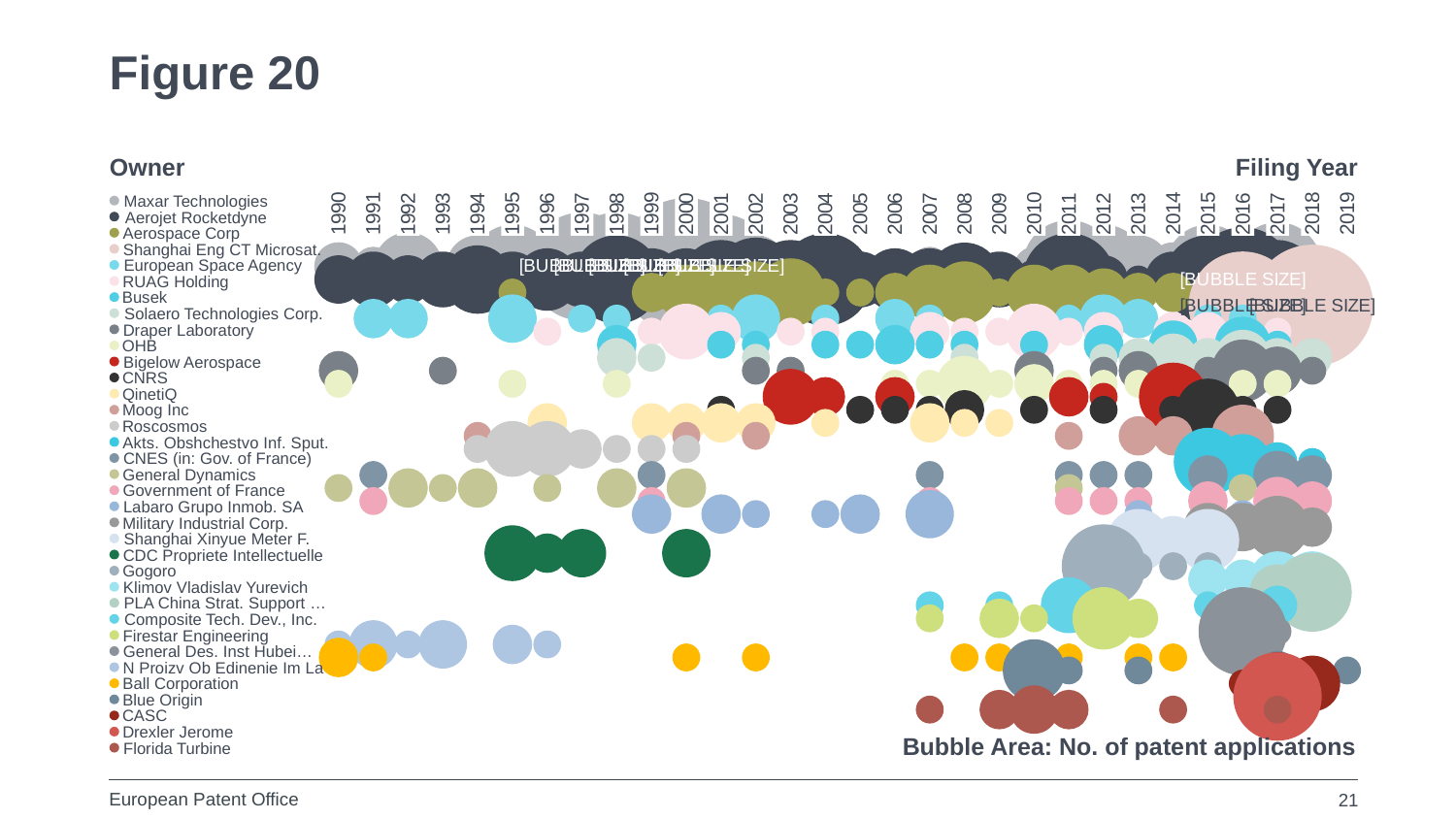
How many owners does the legend of the chart list? 35 What is the label of the horizontal axis of the chart? Filing Year What kind of chart is shown on the slide? Bubble chart What does the bubble area in the chart represent? No. of patent applications How many filing years are shown along the x axis of the chart? 30 What is the earliest filing year shown on the x axis of the chart? 1990 What is the latest filing year shown on the x axis of the chart? 2019